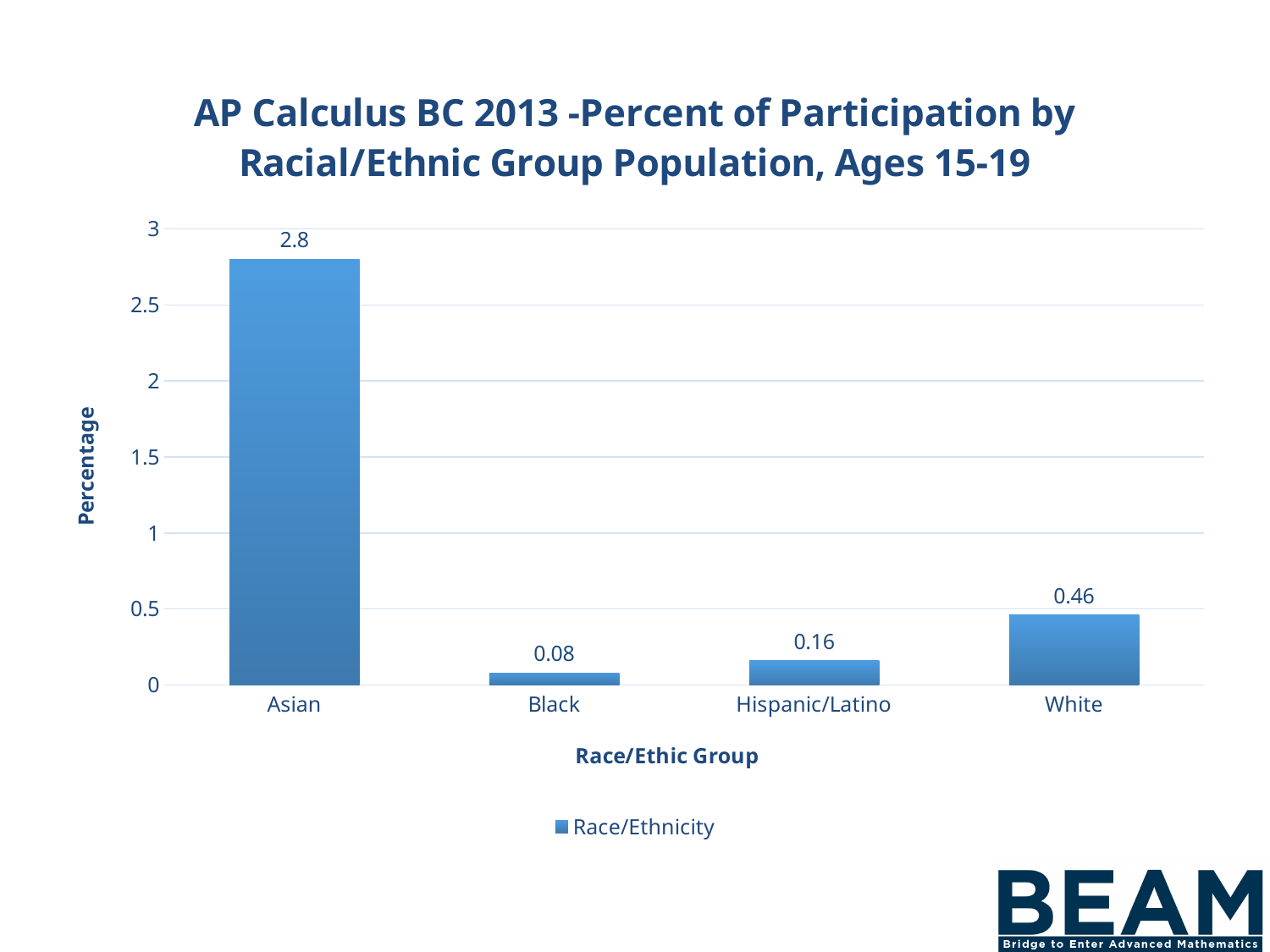
What is the difference between the values for Asian and White? 2.34 Which racial/ethnic group has the lowest value? Black How many racial/ethnic groups are shown on the x axis? 4 What kind of chart is shown on the slide? bar chart What is the value for Asian? 2.8 What is the label of the y axis? Percentage Which is larger, the value for Hispanic/Latino or the value for White? White What is the value for White? 0.46 What is the value for Black? 0.08 Which racial/ethnic group has the highest value? Asian Is the value for Asian greater or less than 2.5? greater What is the value for Hispanic/Latino? 0.16